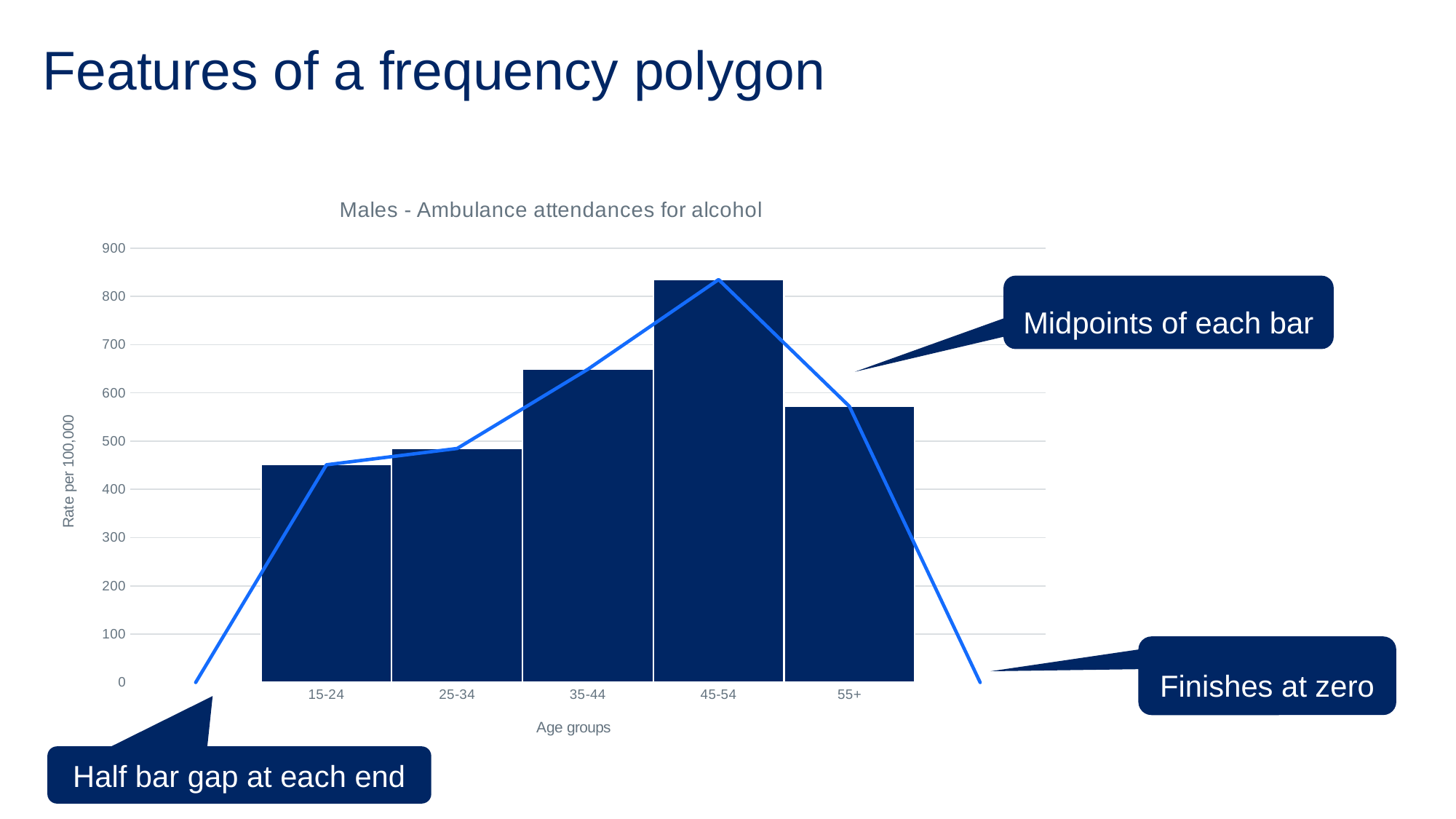
Is the value for the 55+ age group greater or less than 600? less How many age groups are shown on the x axis of the chart? 5 What is the title of the chart? Males - Ambulance attendances for alcohol Which age group has the lowest rate in the chart? 15-24 Is the value for the 45-54 age group greater or less than 800? greater Is the value for the 15-24 age group greater or less than 500? less What is the label on the y axis of the chart? Rate per 100,000 Which has a higher rate, the 35-44 age group or the 55+ age group? 35-44 Do the bar values rise or fall from the 15-24 age group to the 45-54 age group? rise Which age group has the highest rate in the Males - Ambulance attendances for alcohol chart? 45-54